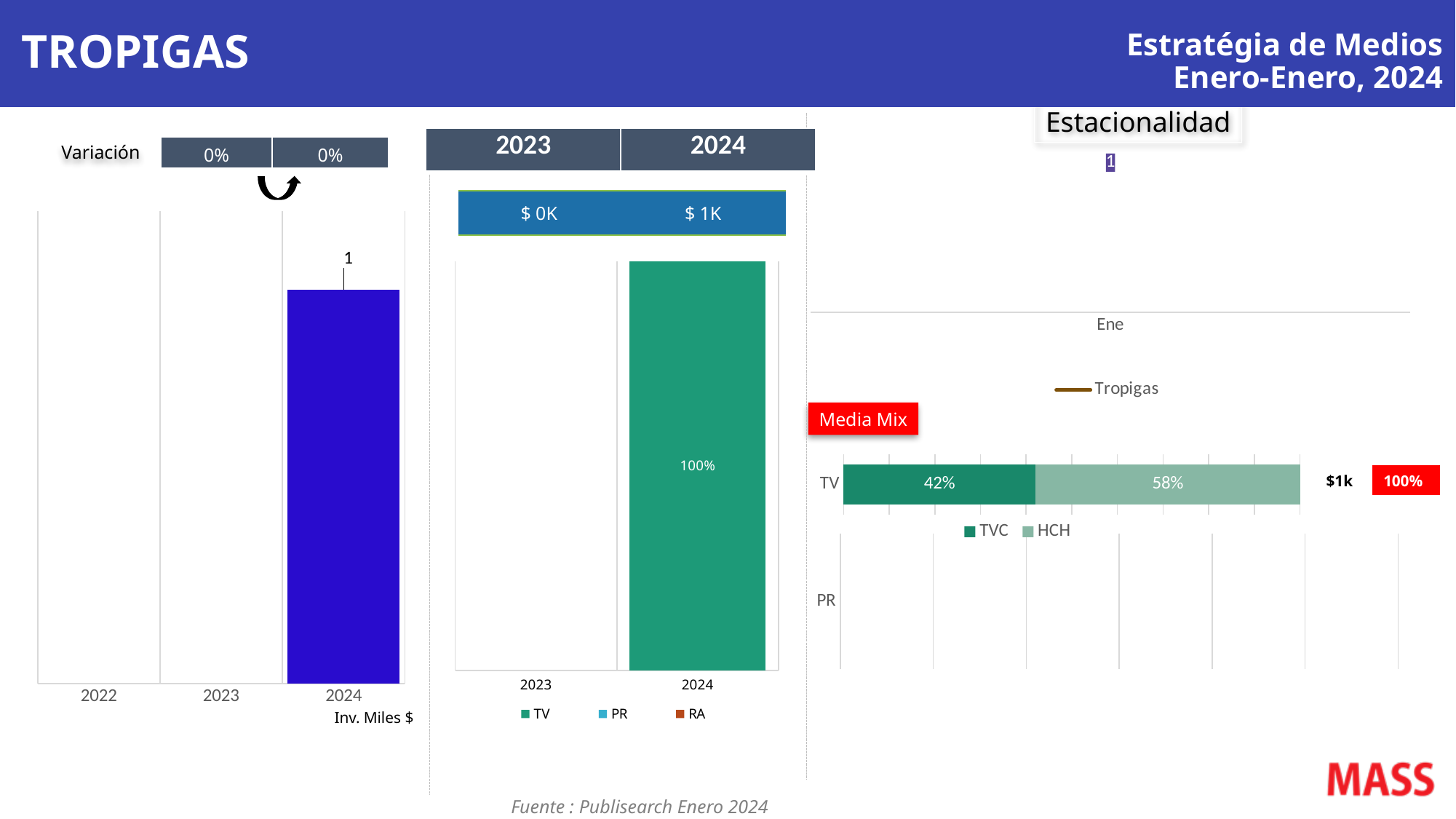
In the Media Mix chart, what is the difference between the HCH and TVC shares of the TV bar? 16% On the left 'Inv. Miles $' bar chart, what is the value for 2024? 1 In the Media Mix chart, how many series does the legend list? 2 On the left 'Inv. Miles $' bar chart, which year has the highest bar? 2024 On the middle stacked bar chart, which series does the 2024 bar belong to according to the legend colour? TV On the left 'Inv. Miles $' bar chart, how many year categories are shown on the x axis? 3 In the Media Mix chart, what is the HCH share of the TV bar? 58% What kind of chart is the left 'Inv. Miles $' chart? bar chart On the middle stacked bar chart with the TV, PR and RA legend, what percentage is labelled on the 2024 bar? 100% In the Media Mix chart, what is the TVC share of the TV bar? 42% On the middle stacked bar chart with the TV, PR and RA legend, how many series does the legend list? 3 In the Media Mix chart, which is larger for TV, TVC or HCH? HCH